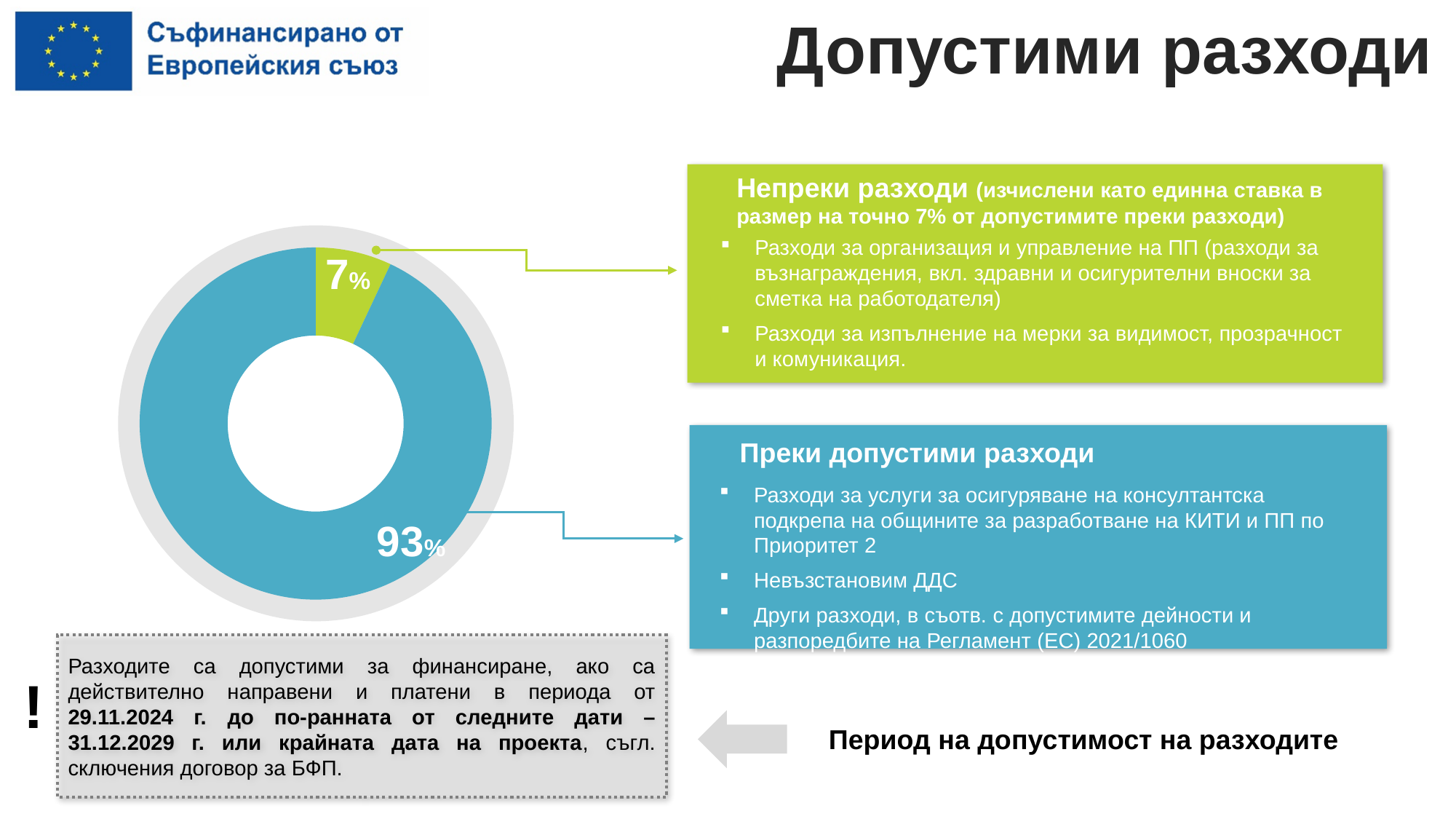
What is the value of the blue slice of the donut chart? 93% What is the total of the two slices in the donut chart? 100% Which slice of the donut chart is the largest? 93% (Преки допустими разходи) What share of the donut chart is labelled 93%? 93% What colour is the slice representing Преки допустими разходи? Blue Which category does the green 7% slice of the donut chart represent? Непреки разходи Which is larger in the donut chart: the slice for Непреки разходи or the slice for Преки допустими разходи? Преки допустими разходи How many slices does the donut chart have? 2 What is the difference between the two slices of the donut chart? 86% What kind of chart is shown on the slide? Donut (pie) chart Which slice of the donut chart is the smallest? 7% (Непреки разходи) What is the value of the green slice of the donut chart? 7%